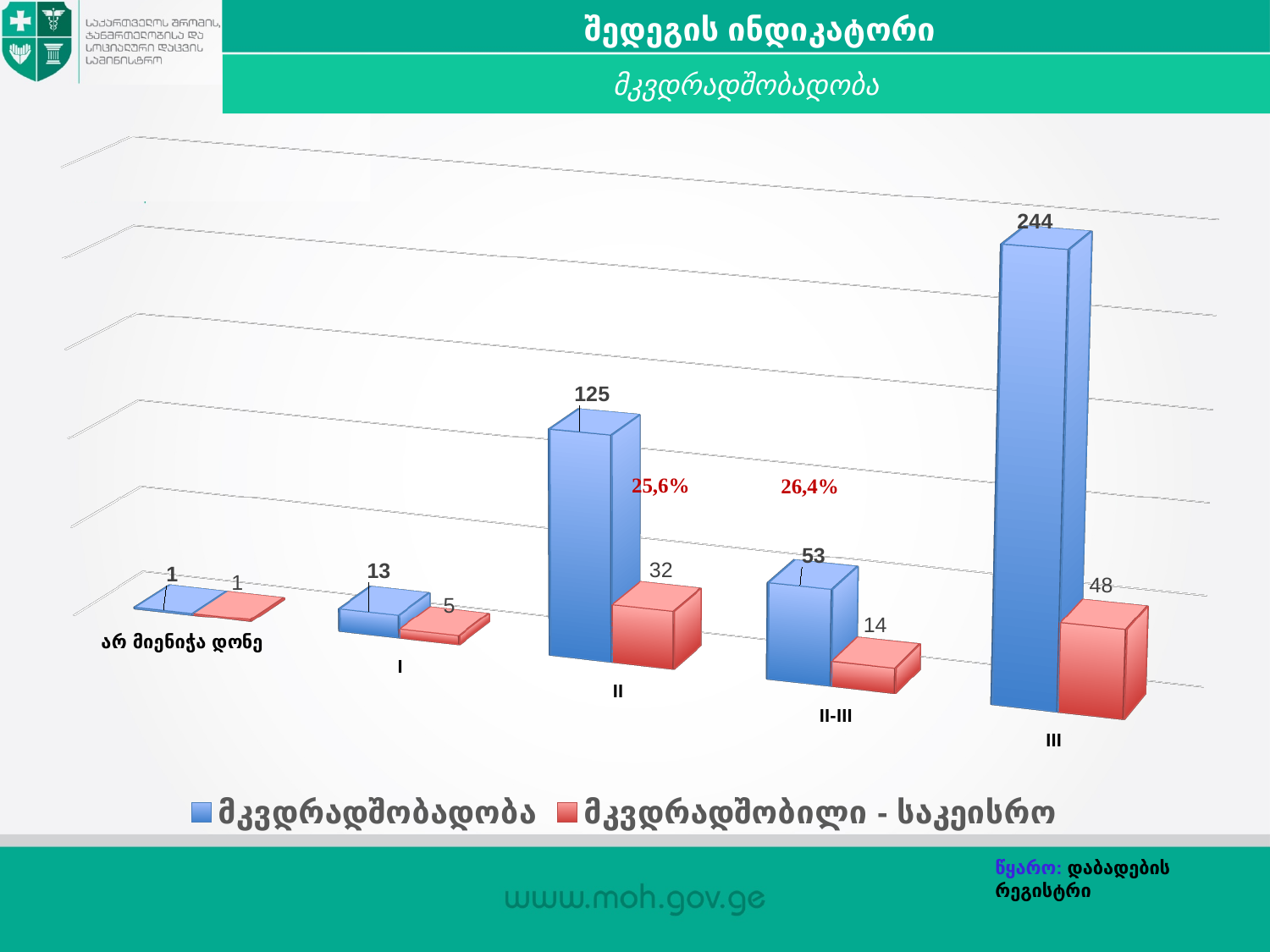
What percentage label is shown next to the bars for category II? 25,6% What is the value of the მკვდრადშობადობა series for category II-III? 53 How many series does the legend list? 2 What is the value of the მკვდრადშობილი - საკეისრო series for category I? 5 Which is larger: the მკვდრადშობილი - საკეისრო value for category III or for category II? III What is the value of the მკვდრადშობადობა series for category III? 244 Which category has the lowest value for the მკვდრადშობილი - საკეისრო series? არ მიენიჭა დონე What is the difference between the მკვდრადშობადობა values for categories III and II? 119 How many categories are shown on the x axis? 5 Which category has the highest value for the მკვდრადშობადობა series? III What kind of chart is shown on the slide? bar chart What is the value of the მკვდრადშობილი - საკეისრო series for category II? 32